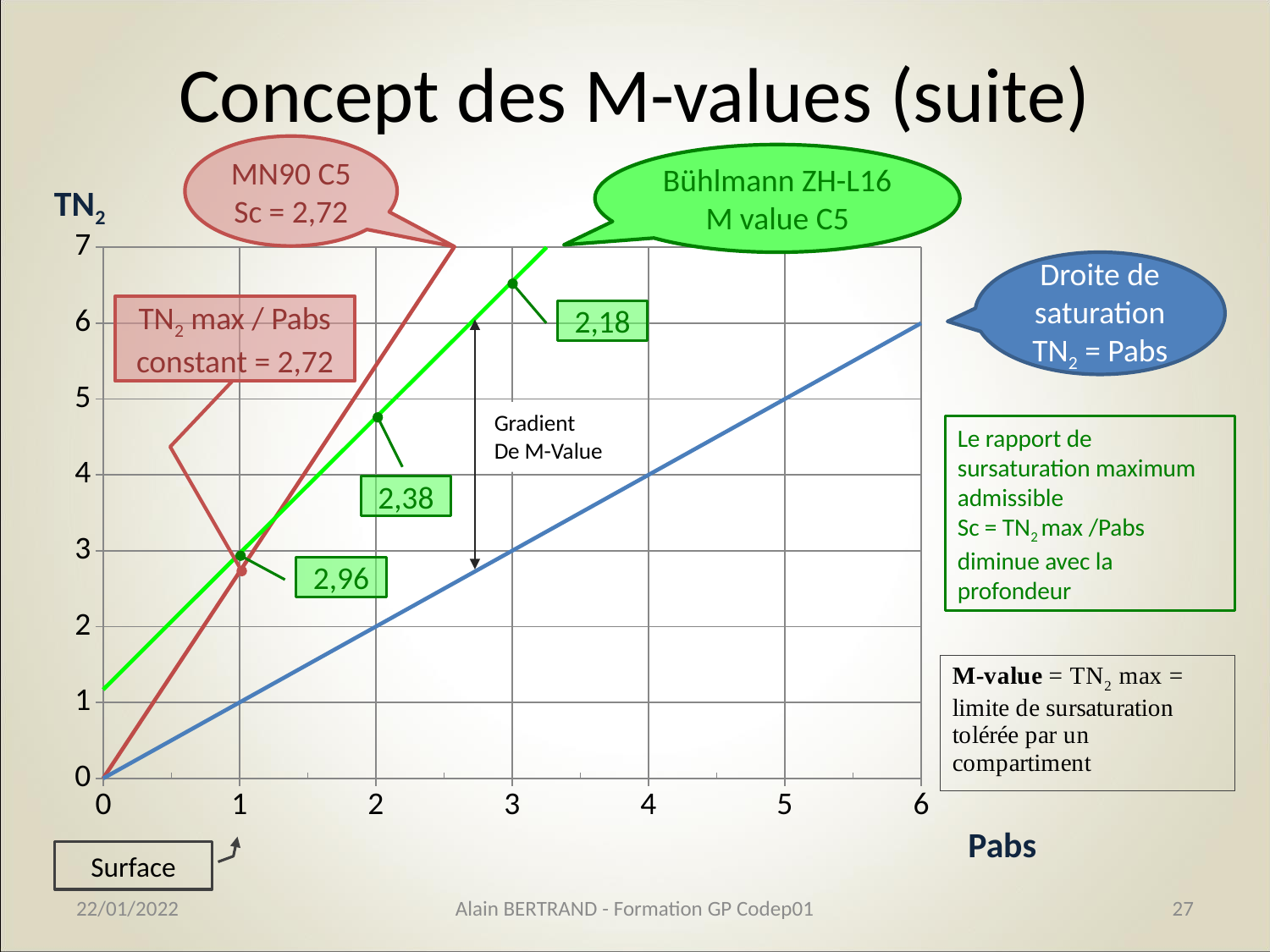
What value label is attached to the point on the green Bühlmann ZH-L16 line at Pabs = 1? 2,96 How many lines are plotted on the chart? 3 What value label is attached to the point on the green Bühlmann ZH-L16 line at Pabs = 2? 2,38 What value label is attached to the point on the green Bühlmann ZH-L16 line at Pabs = 3? 2,18 Is the TN2 value of the red MN90 C5 line at Pabs = 2 greater or less than 5? greater Is the TN2 value of the green Bühlmann ZH-L16 line at Pabs = 2 greater or less than 4? greater What is the label on the vertical axis of the chart? TN2 What is the label on the horizontal axis of the chart? Pabs What is the TN2 value of the blue saturation line (TN2 = Pabs) at Pabs = 6? 6 What kind of chart is shown on the slide? line chart Do the TN2 values of the blue saturation line rise or fall as Pabs increases? rise At Pabs = 3, which line has the higher TN2 value, the green Bühlmann ZH-L16 line or the blue saturation line? the green Bühlmann ZH-L16 line